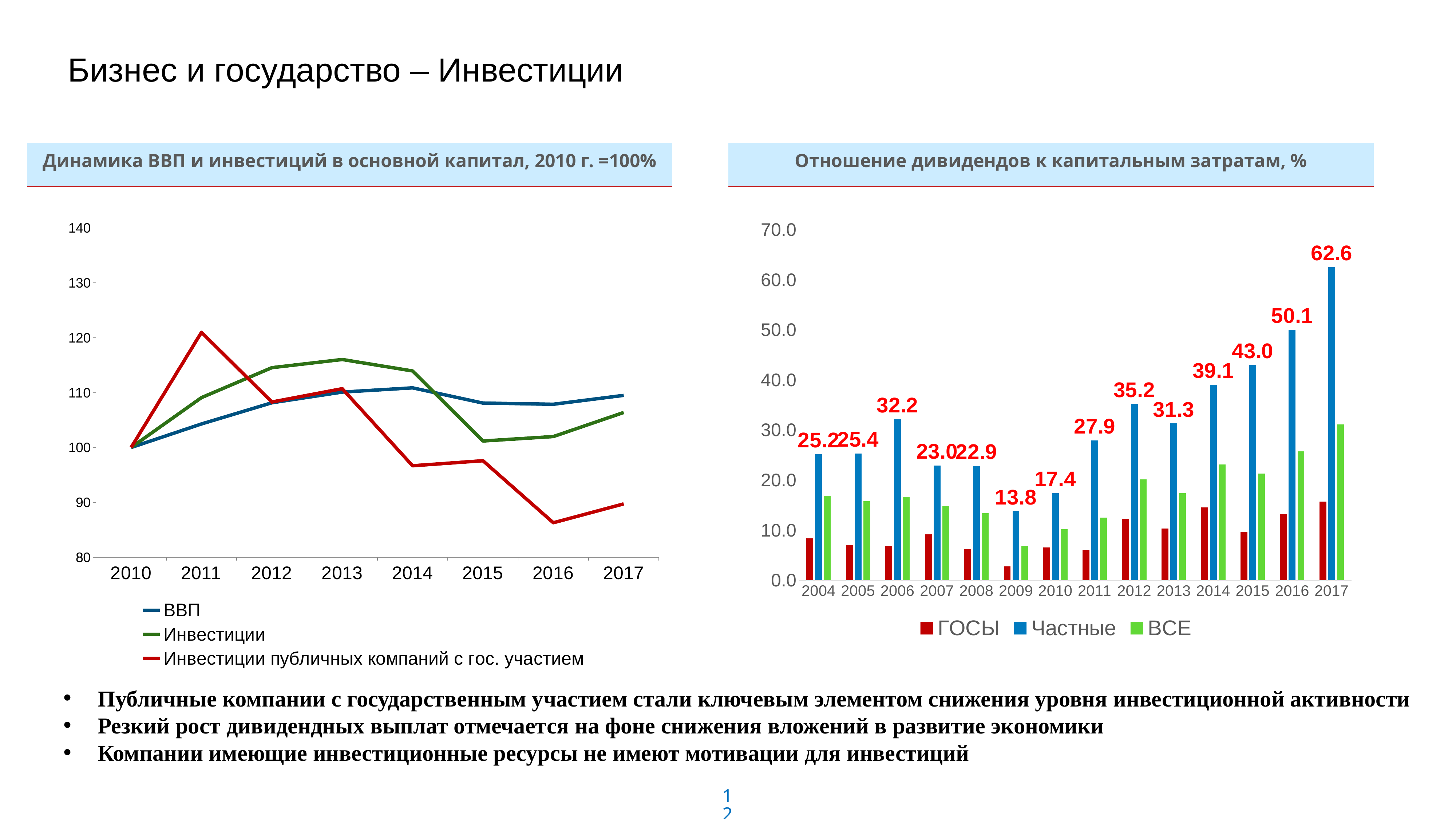
In the chart 'Динамика ВВП и инвестиций в основной капитал, 2010 г. =100%', is the value for 'Инвестиции публичных компаний с гос. участием' in 2016 greater or less than 90? less In the chart 'Отношение дивидендов к капитальным затратам, %', what is the difference between the Частные values for 2017 and 2016? 12.5 In the chart 'Отношение дивидендов к капитальным затратам, %', what is the value for Частные in 2017? 62.6 In the chart 'Динамика ВВП и инвестиций в основной капитал, 2010 г. =100%', what is the value of ВВП in 2010? 100 In the chart 'Динамика ВВП и инвестиций в основной капитал, 2010 г. =100%', in 2011 which is higher: ВВП or 'Инвестиции публичных компаний с гос. участием'? Инвестиции публичных компаний с гос. участием In the chart 'Отношение дивидендов к капитальным затратам, %', how many years are shown on the x axis? 14 In the chart 'Отношение дивидендов к капитальным затратам, %', which year has the lowest value for Частные? 2009 What kind of chart is 'Динамика ВВП и инвестиций в основной капитал, 2010 г. =100%'? line chart In the chart 'Отношение дивидендов к капитальным затратам, %', what is the value for Частные in 2009? 13.8 What kind of chart is 'Отношение дивидендов к капитальным затратам, %'? bar chart In the chart 'Отношение дивидендов к капитальным затратам, %', how many series does the legend list? 3 In the chart 'Отношение дивидендов к капитальным затратам, %', which year has the highest value for Частные? 2017